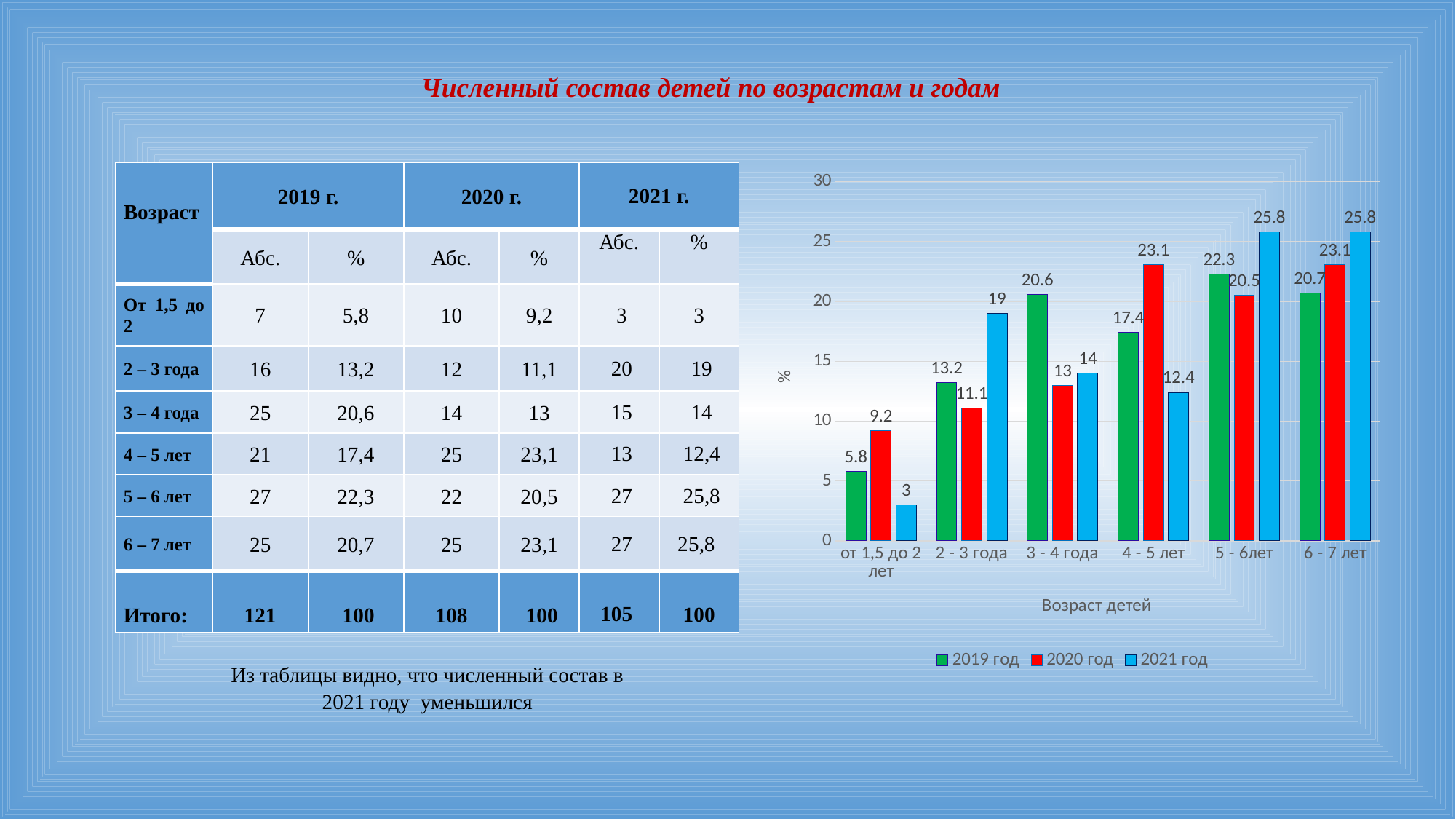
How many series does the chart legend list? 3 In the 4 - 5 лет category, which is larger: the value for 2020 год or for 2021 год? 2020 год Which age category has the lowest value for 2021 год? от 1,5 до 2 лет What is the value for 2019 год in the 3 - 4 года category? 20.6 What is the difference between the 2020 год and 2019 год values in the от 1,5 до 2 лет category? 3.4 What type of chart is shown on the slide? bar chart What is the value for 2020 год in the 4 - 5 лет category? 23.1 What is the value for 2021 год in the 2 - 3 года category? 19 What is the difference between the 2021 год and 2019 год values in the 5 - 6лет category? 3.5 How many age categories are shown on the x axis of the chart? 6 Which age category has the highest value for 2019 год? 5 - 6лет What are the entries in the chart legend? 2019 год, 2020 год, 2021 год